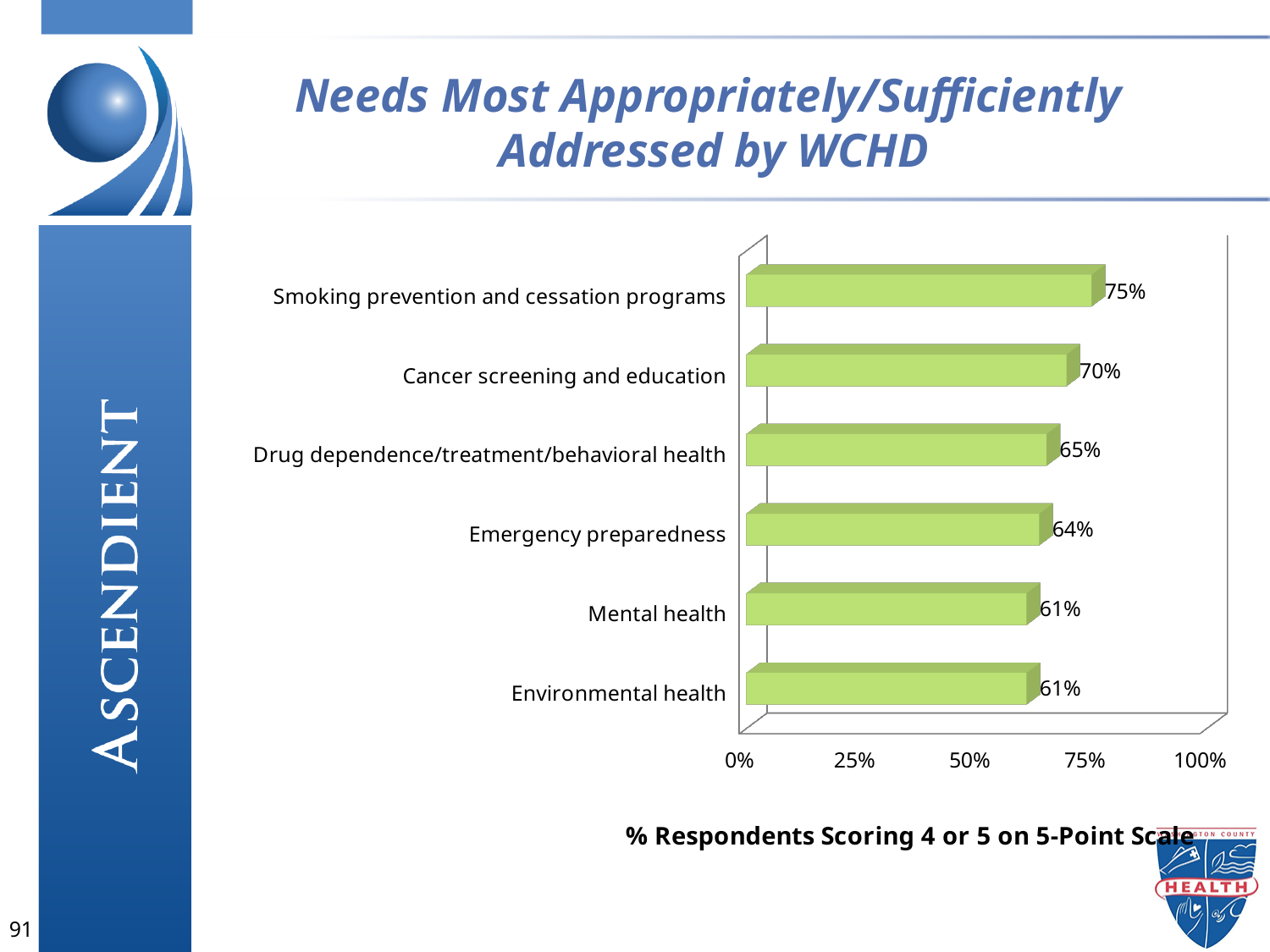
What is the value for Cancer screening and education? 70% What is the value for Smoking prevention and cessation programs? 75% What is the difference between the values for Cancer screening and education and Environmental health? 9% Is the value for Drug dependence/treatment/behavioral health greater or less than 50%? greater Which category has the highest value? Smoking prevention and cessation programs What kind of chart is shown on the slide? Bar chart What is the title of the chart on the slide? Needs Most Appropriately/Sufficiently Addressed by WCHD What is the value for Mental health? 61% What is the difference between the values for Smoking prevention and cessation programs and Drug dependence/treatment/behavioral health? 10% What is the value for Emergency preparedness? 64% Which is larger, the value for Cancer screening and education or the value for Emergency preparedness? Cancer screening and education How many categories are shown in the chart? 6